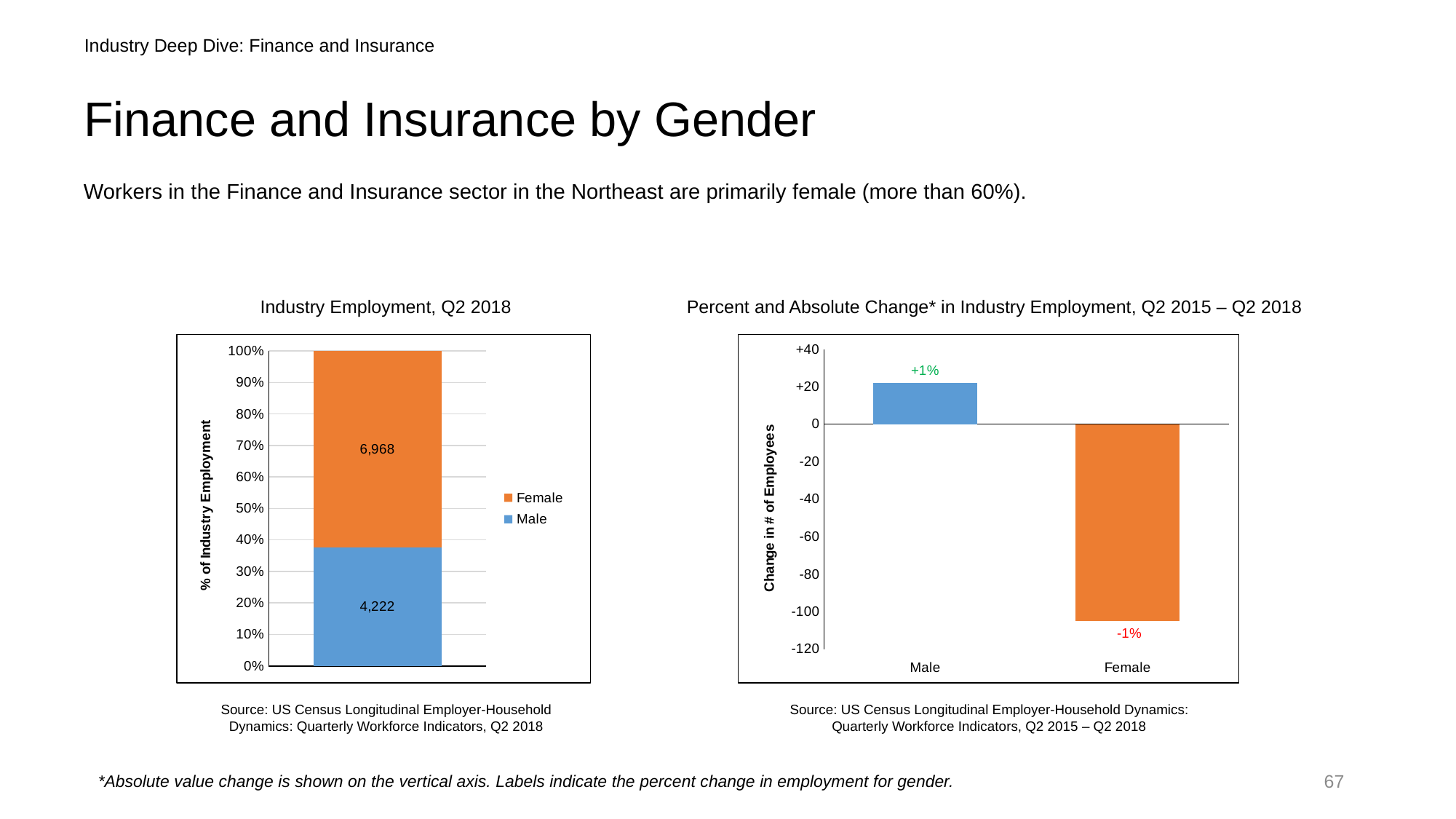
What kind of chart is the 'Percent and Absolute Change in Industry Employment, Q2 2015 – Q2 2018' chart? Bar chart In the 'Percent and Absolute Change in Industry Employment, Q2 2015 – Q2 2018' chart, what percent change label is shown for Female? -1% In the 'Industry Employment, Q2 2018' chart, what is the total of the stacked bar (Female plus Male)? 11,190 In the 'Percent and Absolute Change in Industry Employment, Q2 2015 – Q2 2018' chart, what percent change label is shown for Male? +1% In the 'Industry Employment, Q2 2018' chart, which is larger, the Female value or the Male value? Female In the 'Industry Employment, Q2 2018' chart, which colour represents Female? Orange In the 'Industry Employment, Q2 2018' chart, what is the value shown for Female? 6,968 In the 'Industry Employment, Q2 2018' chart, what is the difference between the Female and Male values? 2,746 In the 'Percent and Absolute Change in Industry Employment, Q2 2015 – Q2 2018' chart, is the change in number of employees for Female greater or less than -100? less In the 'Percent and Absolute Change in Industry Employment, Q2 2015 – Q2 2018' chart, is the change in number of employees for Male greater or less than 0? greater In the 'Industry Employment, Q2 2018' chart, how many series does the legend list? 2 In the 'Industry Employment, Q2 2018' chart, what is the value shown for Male? 4,222